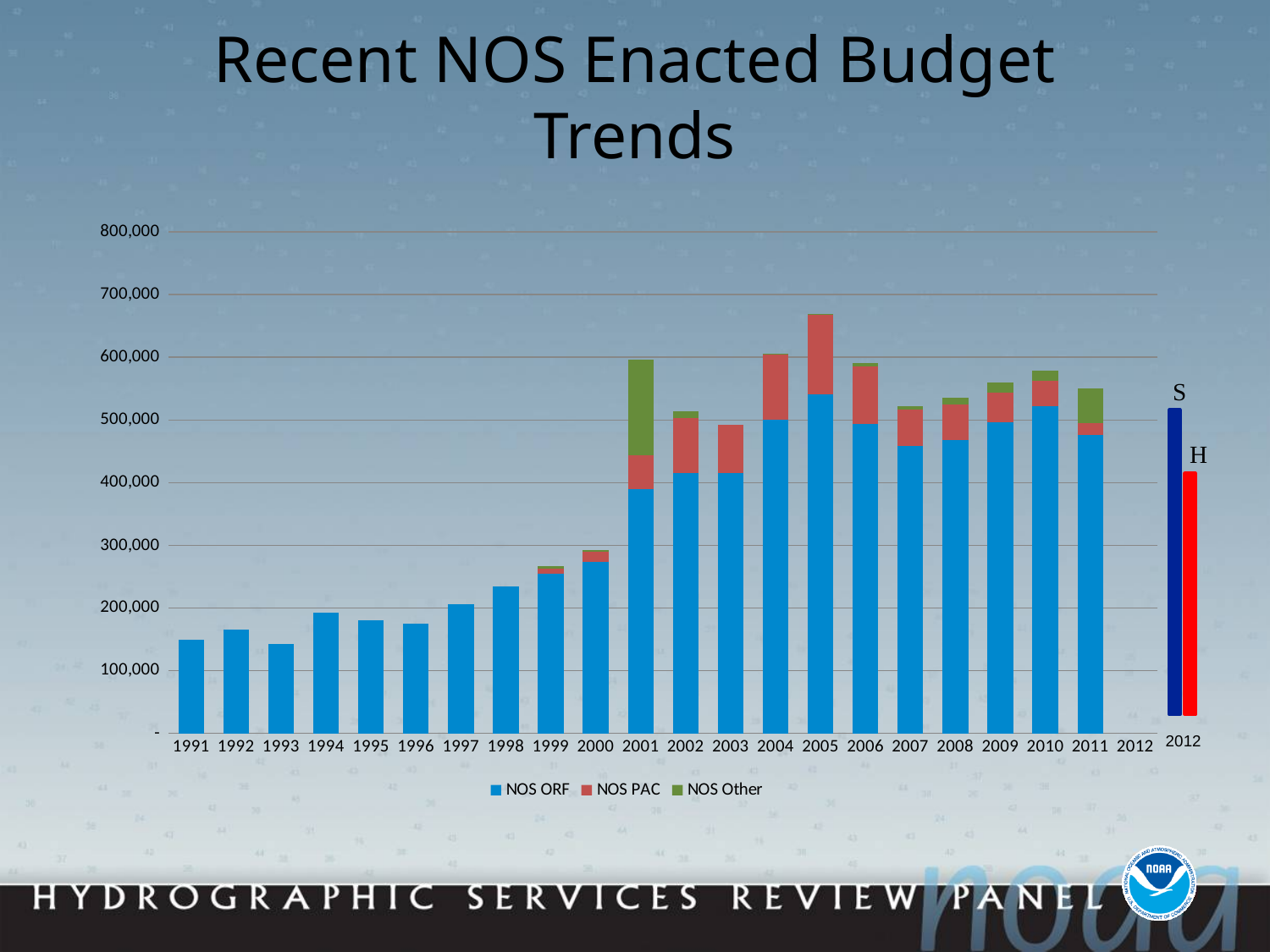
Is the total value for 1991 greater or less than 200,000? less Is the total value for 2005 greater or less than 600,000? greater Which year has the larger total bar, 1991 or 1999? 1999 Do the total bar values generally rise or fall from 1991 to 2000? Rise Which year has the larger total bar, 2005 or 2010? 2005 What is the title of the chart? Recent NOS Enacted Budget Trends Which year has the highest total bar in the chart? 2005 How many series does the chart legend list? 3 Is the total value for 2010 greater or less than 500,000? greater Which colour represents NOS Other in the chart? Green What kind of chart is shown on the slide? Stacked bar chart